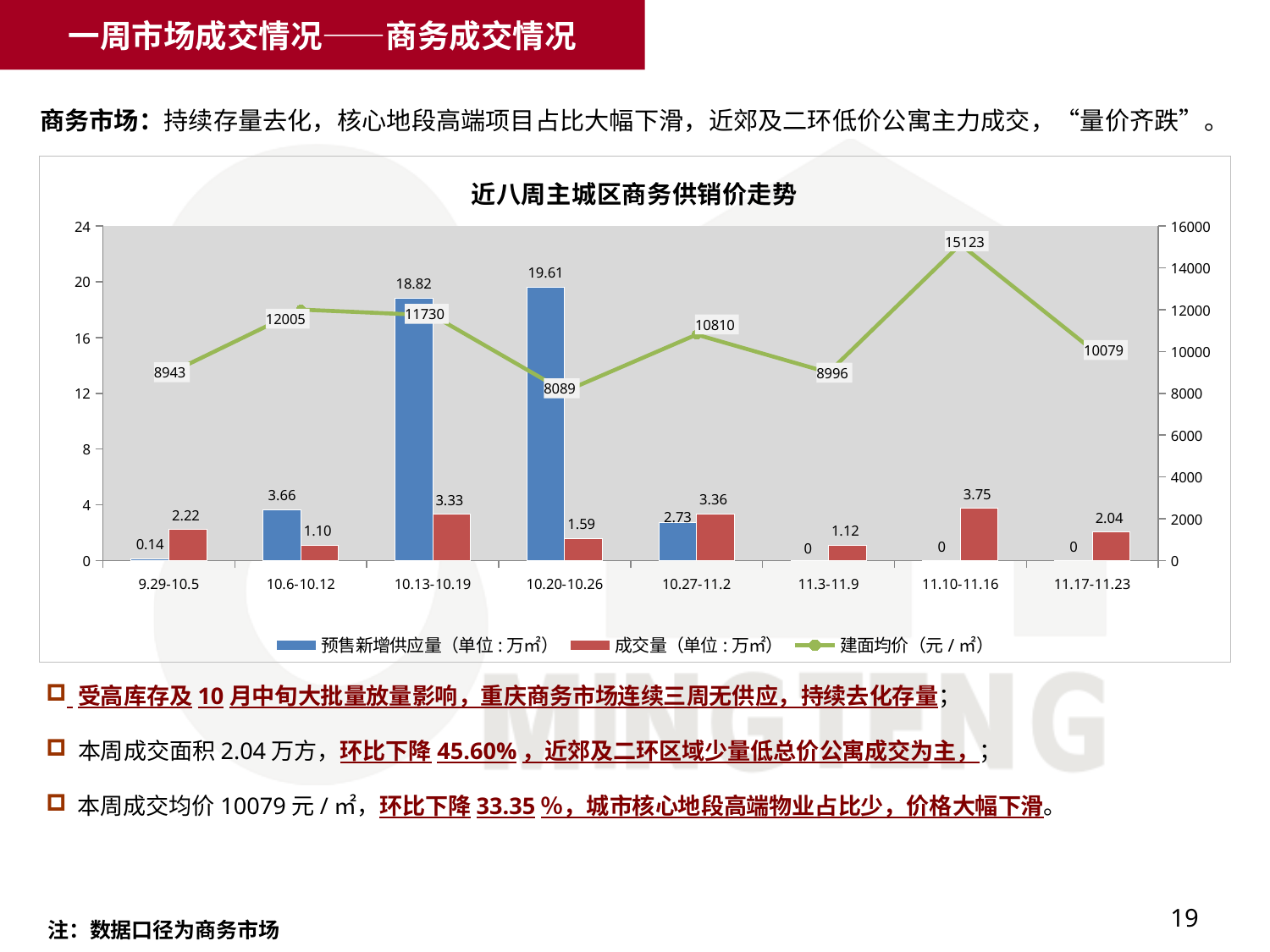
Which week has the highest 预售新增供应量? 10.20-10.26 What kind of chart is this? Combined bar and line chart Which week has the highest 建面均价? 11.10-11.16 What is the title of the chart? 近八周主城区商务供销价走势 What is the difference between the 成交量 for 11.10-11.16 and 11.17-11.23? 1.71 What is the 成交量 value for 11.10-11.16? 3.75 How many series does the legend list? 3 What is the 建面均价 value for 10.20-10.26? 8089 Which week has the lowest 建面均价? 10.20-10.26 How many weeks are shown on the x axis? 8 Which is larger, the 成交量 for 10.27-11.2 or for 10.6-10.12? 10.27-11.2 What is the 预售新增供应量 value for 10.13-10.19? 18.82